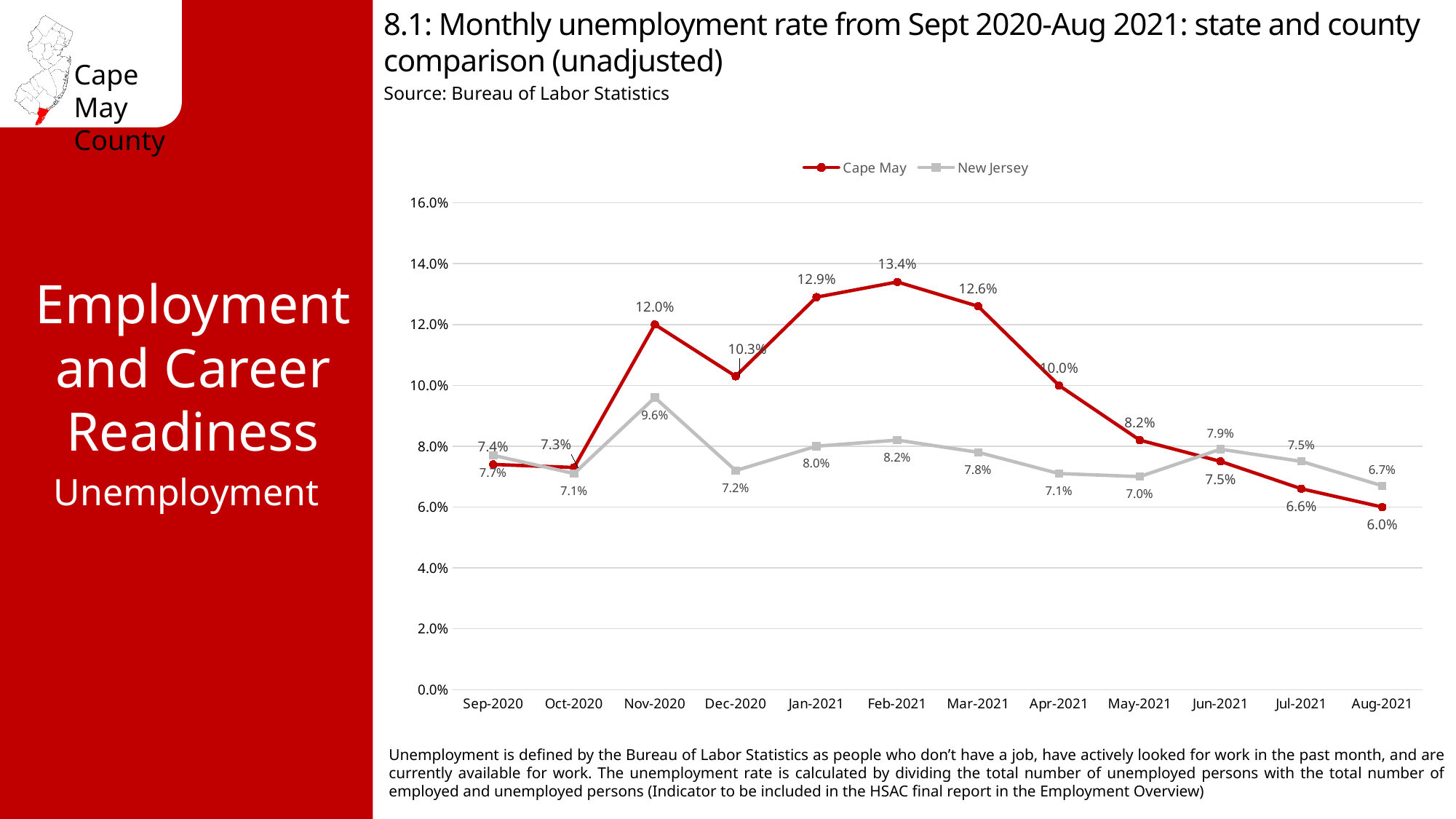
In which month does the Cape May series reach its highest value? Feb-2021 How many months are plotted on the x axis? 12 What is the New Jersey unemployment rate for Nov-2020? 9.6% Does the Cape May series rise or fall from Feb-2021 to Aug-2021? fall In which month is the New Jersey series at its lowest value? Aug-2021 Is the Cape May value for Nov-2020 greater or less than 10.0%? greater How many series does the legend list? 2 What is the difference between the Cape May and New Jersey rates in Feb-2021? 5.2% Which series has the higher value in Jun-2021, Cape May or New Jersey? New Jersey What is the Cape May unemployment rate for Aug-2021? 6.0% What is the Cape May unemployment rate for Feb-2021? 13.4% What kind of chart is shown on the slide? line chart